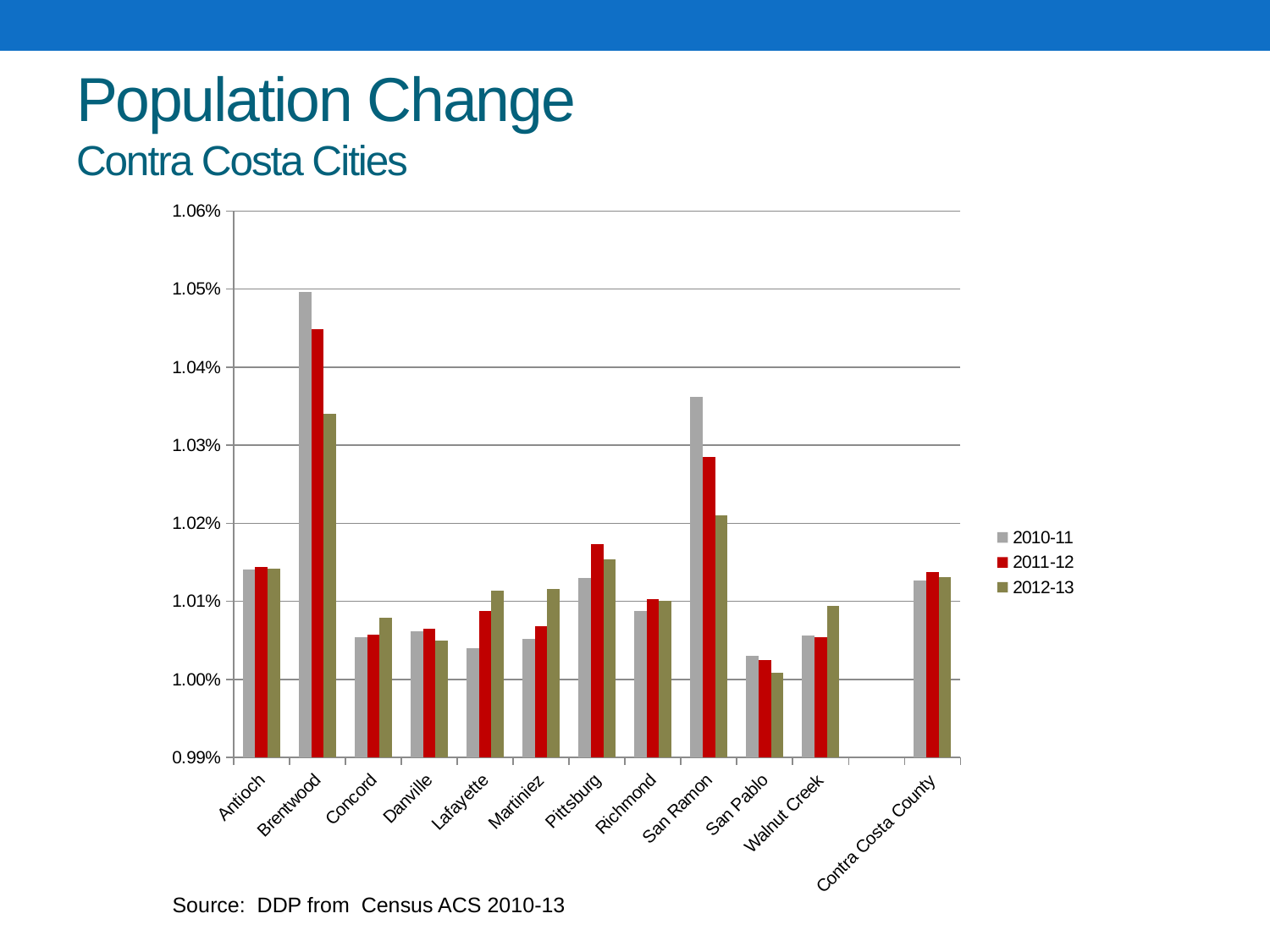
Which city has the lowest bar in the chart? San Pablo Is the 2012-13 value for San Pablo greater or less than 1.01%? less Do the values for Brentwood rise or fall from 2010-11 to 2012-13? fall How many series does the legend list? 3 How many cities or areas are shown along the x axis? 12 Is the 2011-12 value for Pittsburg greater or less than 1.01%? greater Which city has the highest bar in the chart? Brentwood Which series is shown in red in the legend? 2011-12 Is the 2010-11 value for Brentwood greater or less than 1.04%? greater Which is larger, the 2010-11 value for Brentwood or the 2010-11 value for San Ramon? Brentwood What kind of chart is shown on the slide? bar chart